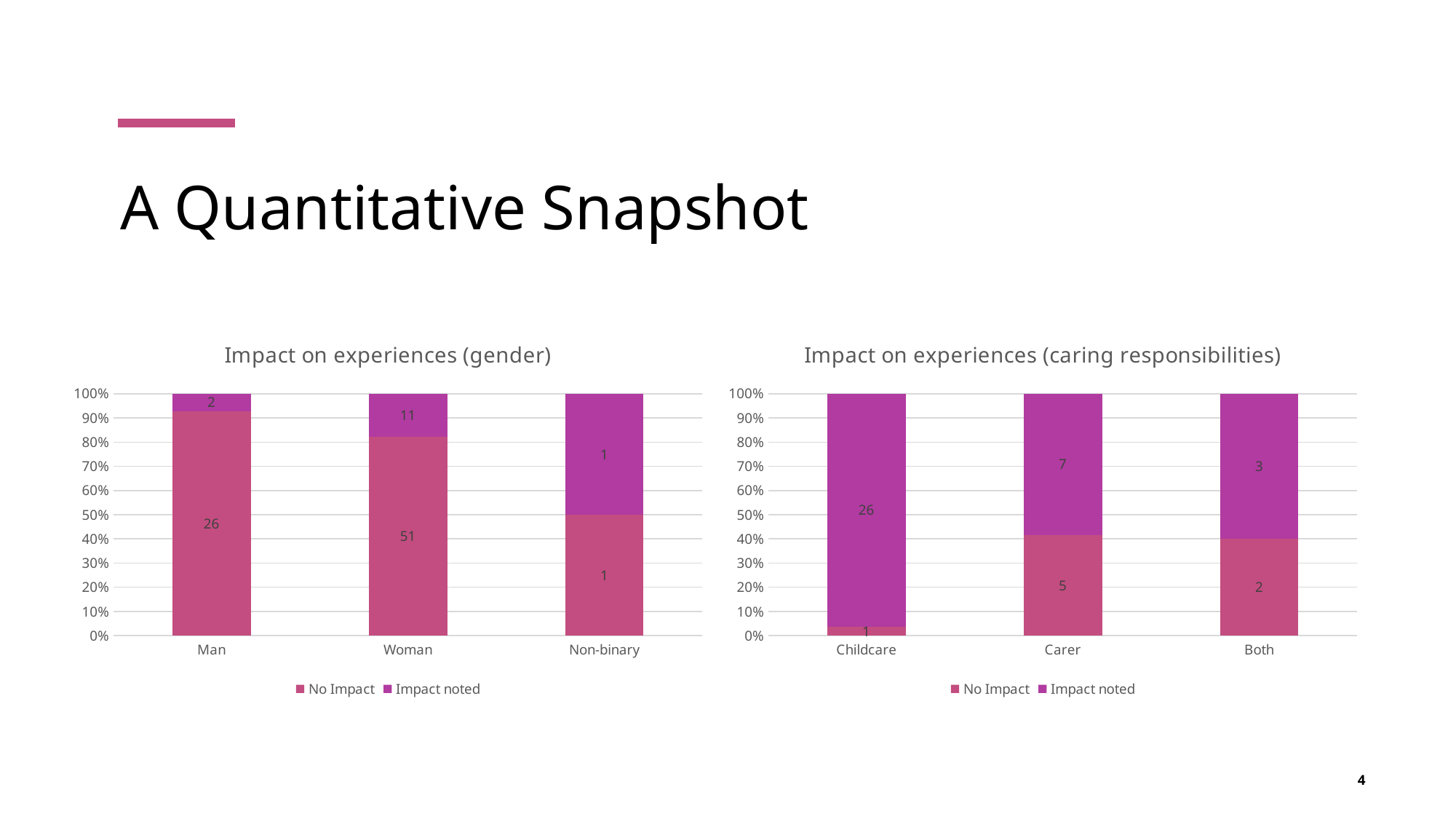
In the 'Impact on experiences (gender)' chart, what is the No Impact value for Woman? 51 In the 'Impact on experiences (caring responsibilities)' chart, is the No Impact share for Carer greater or less than 50%? less In the 'Impact on experiences (caring responsibilities)' chart, what is the Impact noted value for Childcare? 26 In the 'Impact on experiences (gender)' chart, which category has the highest No Impact value? Woman In the 'Impact on experiences (caring responsibilities)' chart, which category has the lowest No Impact value? Childcare In the 'Impact on experiences (gender)' chart, what is the total count for Woman (No Impact plus Impact noted)? 62 In the 'Impact on experiences (caring responsibilities)' chart, what is the No Impact value for Carer? 5 How many series does the legend of the 'Impact on experiences (gender)' chart list? 2 In the 'Impact on experiences (gender)' chart, how many categories are shown on the x axis? 3 In the 'Impact on experiences (caring responsibilities)' chart, what is the difference between the Impact noted values for Carer and Both? 4 What kind of chart is 'Impact on experiences (caring responsibilities)'? Stacked bar chart In the 'Impact on experiences (gender)' chart, what is the Impact noted value for Man? 2